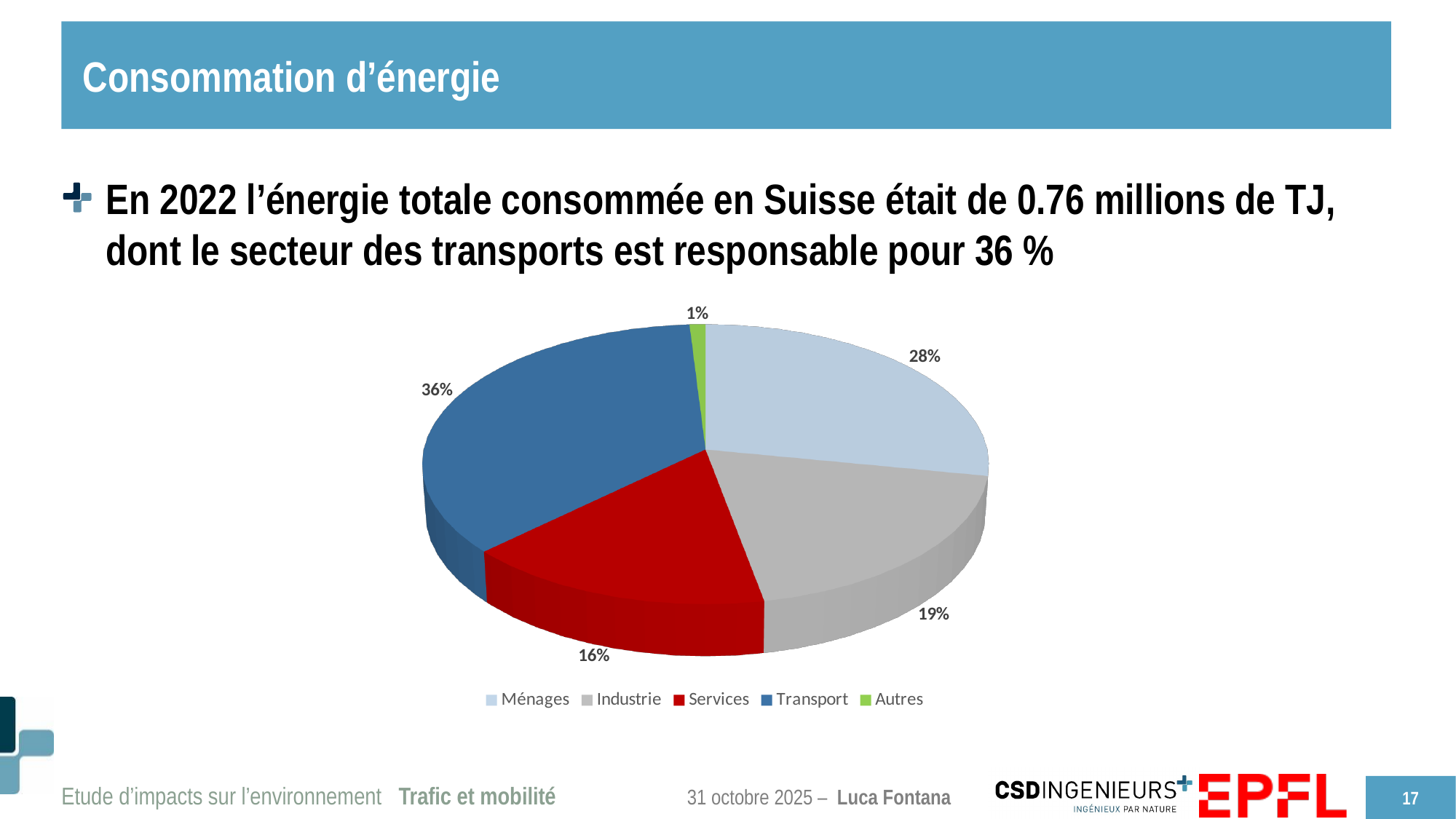
What colour is the Services slice in the pie chart? Red What share of the pie does Transport account for? 36% What is the difference in percentage points between the Transport and Ménages slices? 8 Which slice is larger, Industrie or Services? Industrie What share of the pie does Services account for? 16% What share of the pie does Ménages account for? 28% What share of the pie does Autres account for? 1% Which category has the largest slice of the pie? Transport What kind of chart is shown on the slide? Pie chart Which category has the smallest slice of the pie? Autres How many categories does the pie chart show? 5 What share of the pie does Industrie account for? 19%